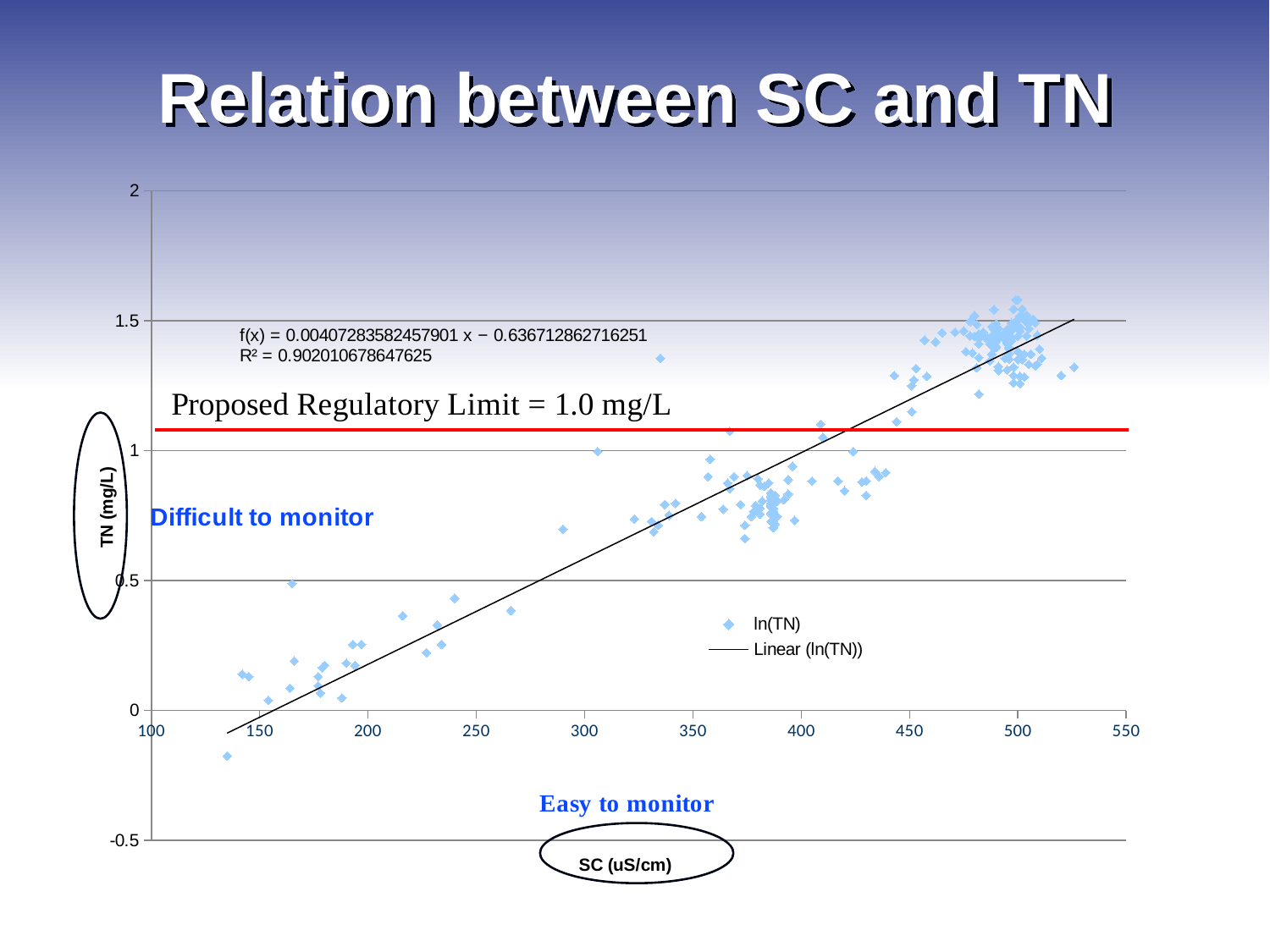
What are the two entries in the chart legend? ln(TN) and Linear (ln(TN)) What is the R² value printed on the chart? R² = 0.902010678647625 What is the label of the y axis? TN (mg/L) What is the proposed regulatory limit shown by the red line on the chart? 1.0 mg/L What is the equation of the linear trendline printed on the chart? f(x) = 0.00407283582457901 x − 0.636712862716251 Is the TN value for the points around SC = 150 greater or less than 0.5? less What is the title of the chart on the slide? Relation between SC and TN What is the label of the x axis? SC (uS/cm) Is the TN value for the cluster of points around SC = 500 greater or less than 1? greater How many series does the chart legend list? 2 Do the TN values generally rise or fall as SC increases along the x axis? Rise What kind of chart is shown on the slide? Scatter plot